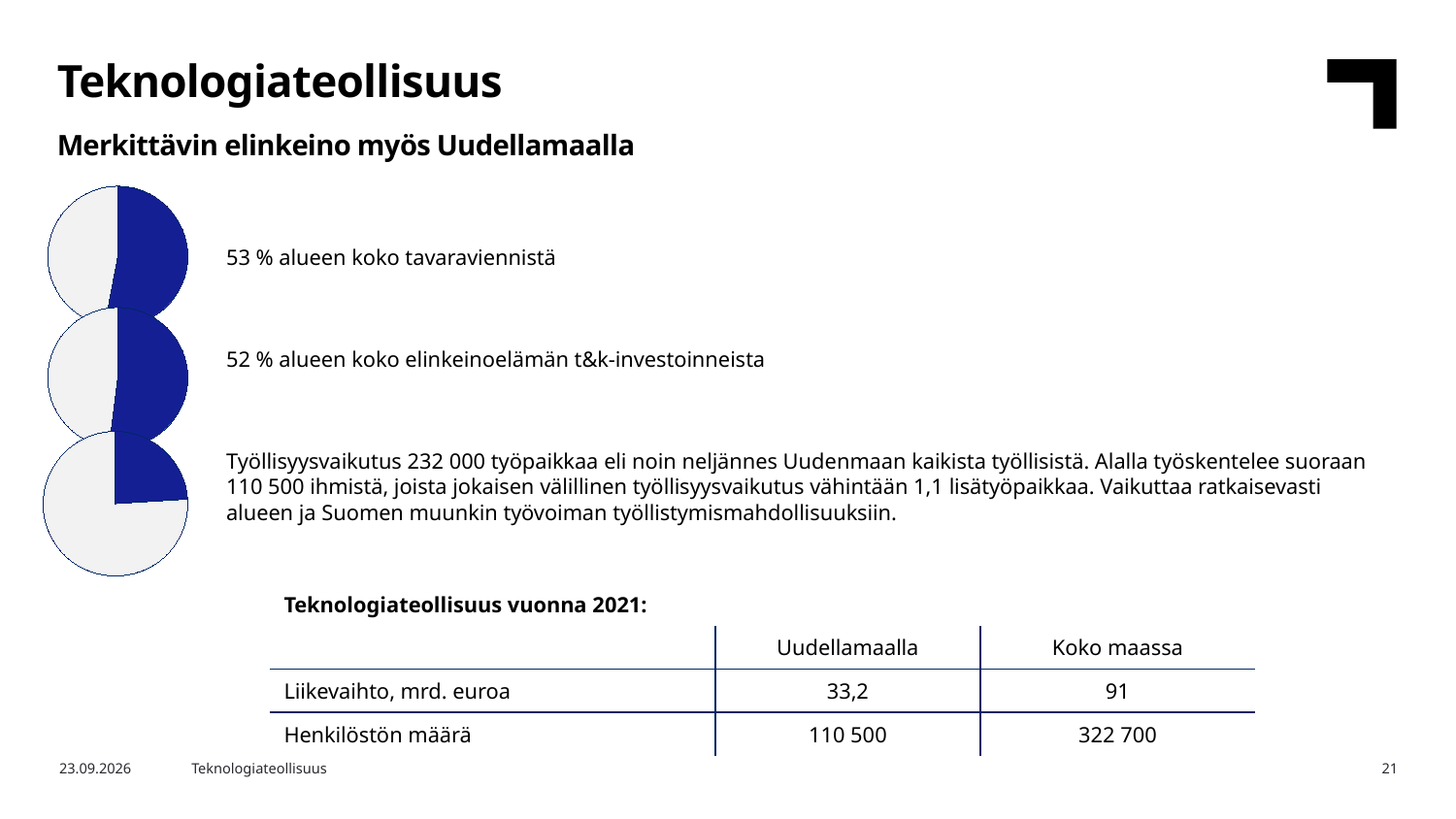
In the middle pie chart, is the highlighted slice greater or less than 50 %? greater What does the highlighted slice in the top pie chart represent? Share of the region's total goods exports (alueen koko tavaravienti) What kind of chart is shown at the top left of the slide? Pie chart How many pie charts are shown on the slide? 3 In the middle pie chart, what share of the region's business R&D investments (t&k-investoinnit) does the highlighted slice represent? 52 % How many slices does each pie chart on the slide have? 2 What is the difference in percentage points between the highlighted share in the top pie chart (53 %) and the middle pie chart (52 %)? 1 percentage point Which pie chart has the larger highlighted slice: the top one (goods exports) or the bottom one (employment)? The top one What colour is the highlighted slice in the pie charts? Dark blue In the bottom pie chart, is the highlighted slice greater or less than 50 %? less In the top pie chart, what share of the region's total goods exports (tavaravienti) does the highlighted slice represent? 53 %